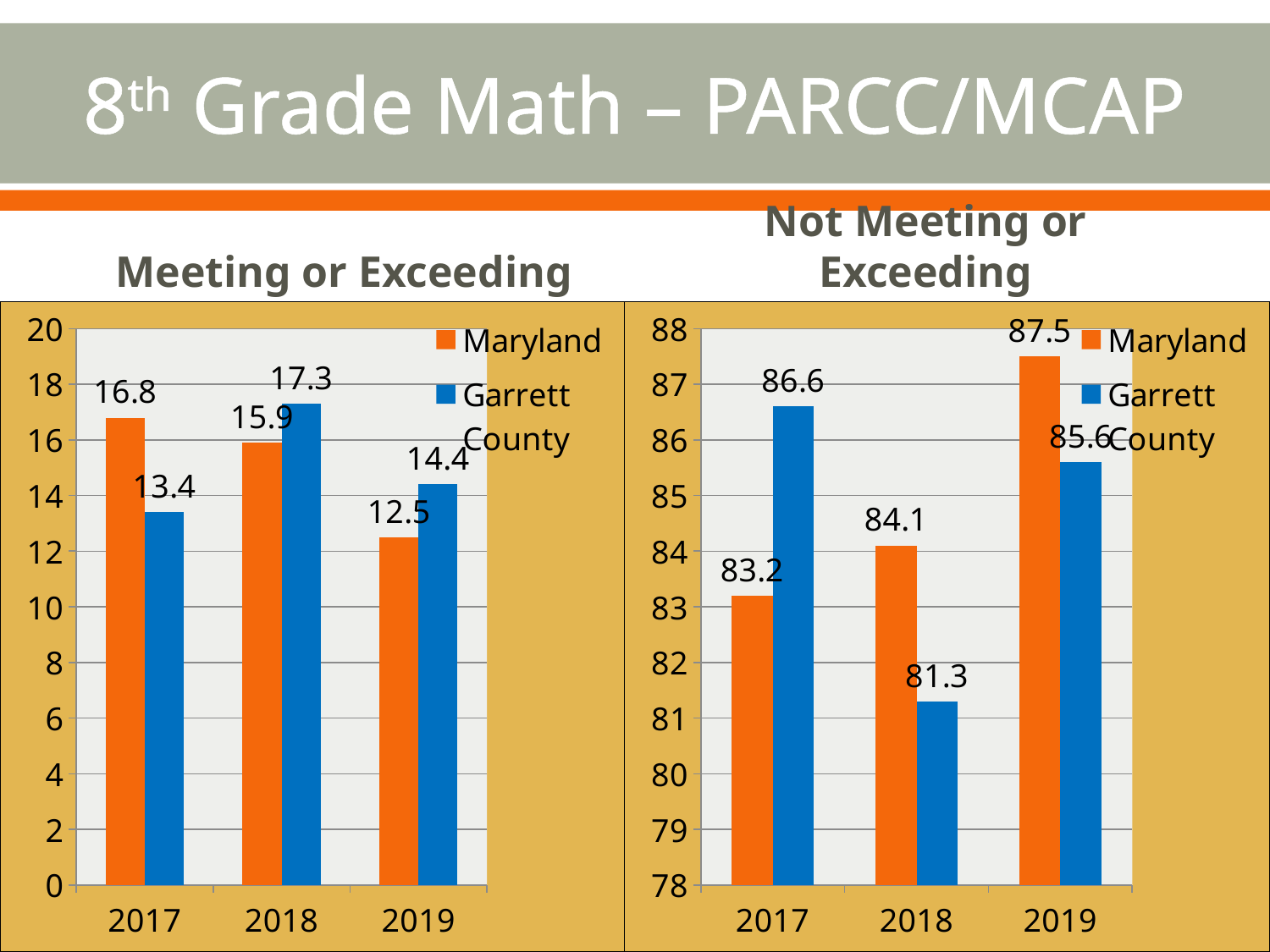
In the 'Meeting or Exceeding' chart, which year has the highest value for Garrett County? 2018 In the 'Not Meeting or Exceeding' chart, what is the value for Garrett County in 2018? 81.3 In the 'Meeting or Exceeding' chart, what is the value for Maryland in 2017? 16.8 How many years are shown on the x axis of the 'Meeting or Exceeding' chart? 3 In the 'Not Meeting or Exceeding' chart, which is larger in 2017, Maryland or Garrett County? Garrett County In the 'Not Meeting or Exceeding' chart, do the Maryland values rise or fall from 2017 to 2019? Rise In the 'Not Meeting or Exceeding' chart, what is the value for Maryland in 2019? 87.5 In the 'Meeting or Exceeding' chart, what is the difference between Maryland and Garrett County in 2017? 3.4 How many series does the legend of the 'Not Meeting or Exceeding' chart list? 2 In the 'Not Meeting or Exceeding' chart, which year has the lowest value for Maryland? 2017 What kind of chart is the 'Meeting or Exceeding' chart? Bar chart In the 'Meeting or Exceeding' chart, what is the value for Garrett County in 2019? 14.4